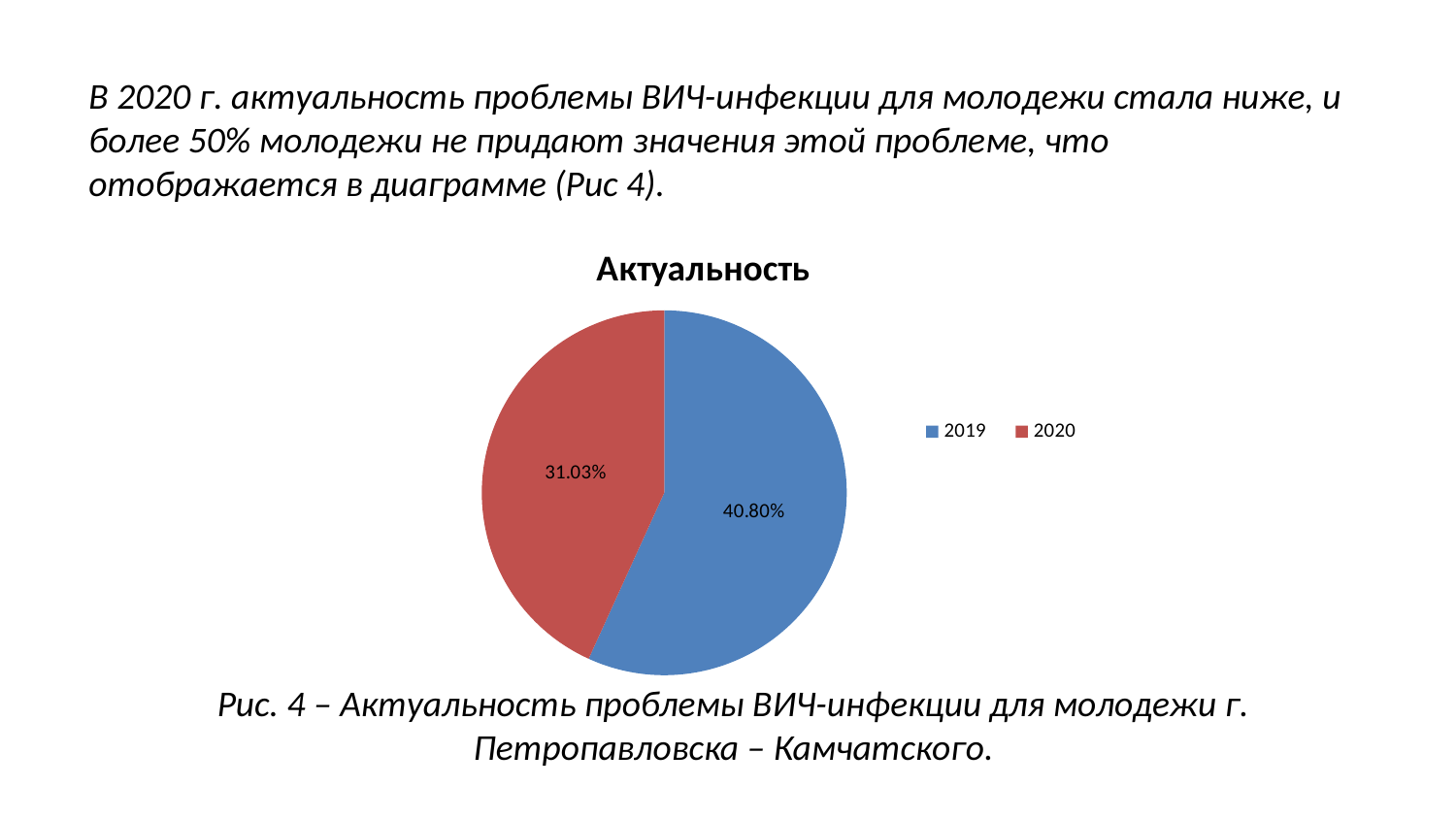
What value is shown for 2019 in the pie chart? 40.80% What colour is the slice for 2020? red Which year has the larger slice in the pie chart? 2019 How many entries does the legend list? 2 Which year has the smaller slice in the pie chart? 2020 What kind of chart is shown on the slide? pie chart Is the value for 2019 larger or smaller than the value for 2020? larger What is the difference between the values for 2019 and 2020? 9.77% What is the title of the chart? Актуальность How many slices does the pie chart have? 2 What value is shown for 2020 in the pie chart? 31.03%